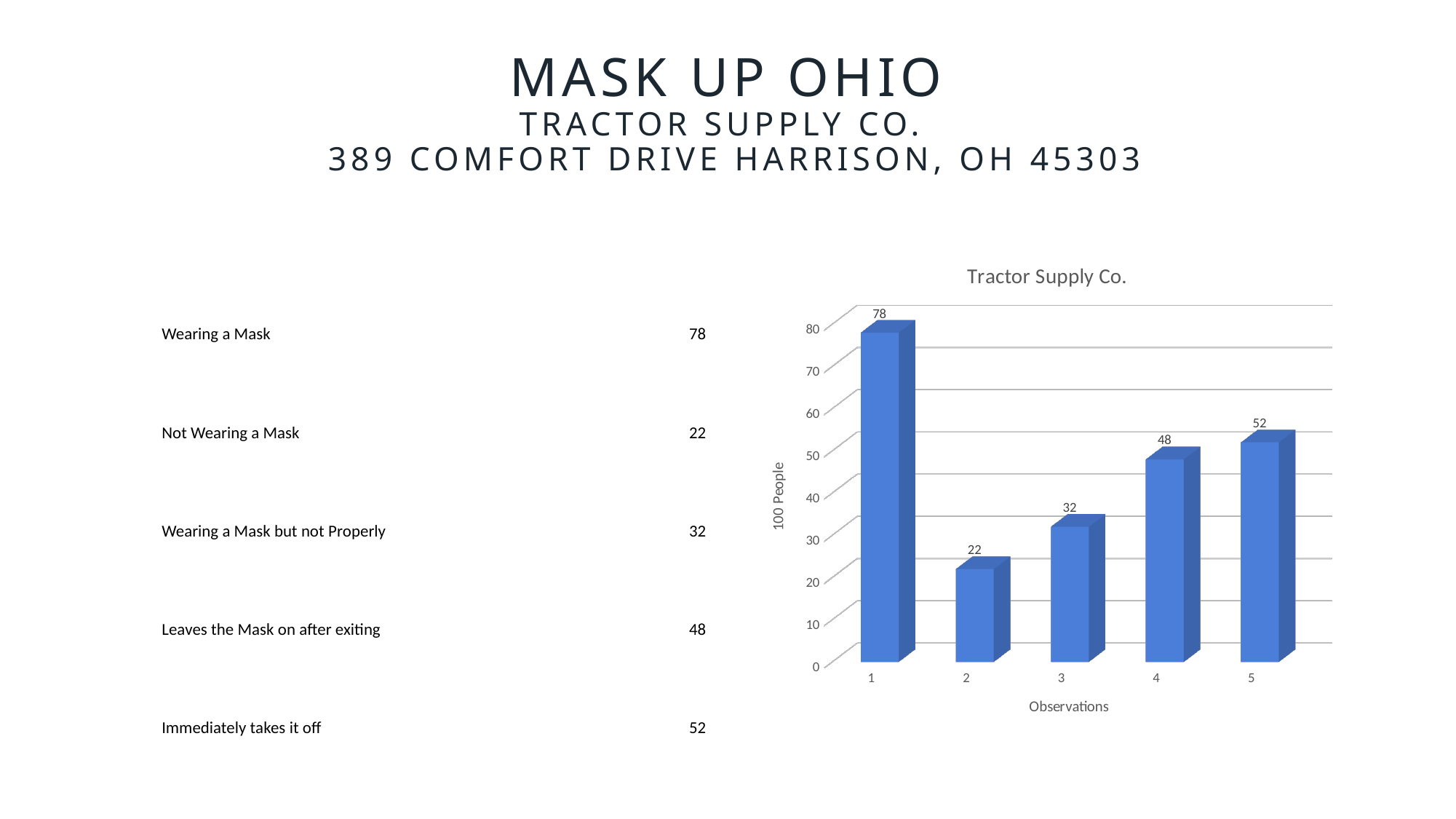
What is the difference between the values for observation 5 and observation 4? 4 What kind of chart is shown on the slide? Bar chart Which is larger, the value for observation 3 or the value for observation 4? Observation 4 What is the title of the chart? Tractor Supply Co. How many bars are plotted in the chart? 5 Which observation has the highest value in the chart? 1 What is the difference between the values for observation 1 and observation 2? 56 What is the value for observation 5 in the chart? 52 Which observation has the lowest value in the chart? 2 What is the label of the vertical axis of the chart? 100 People What is the value for observation 3 in the chart? 32 What is the value for observation 1 in the chart? 78